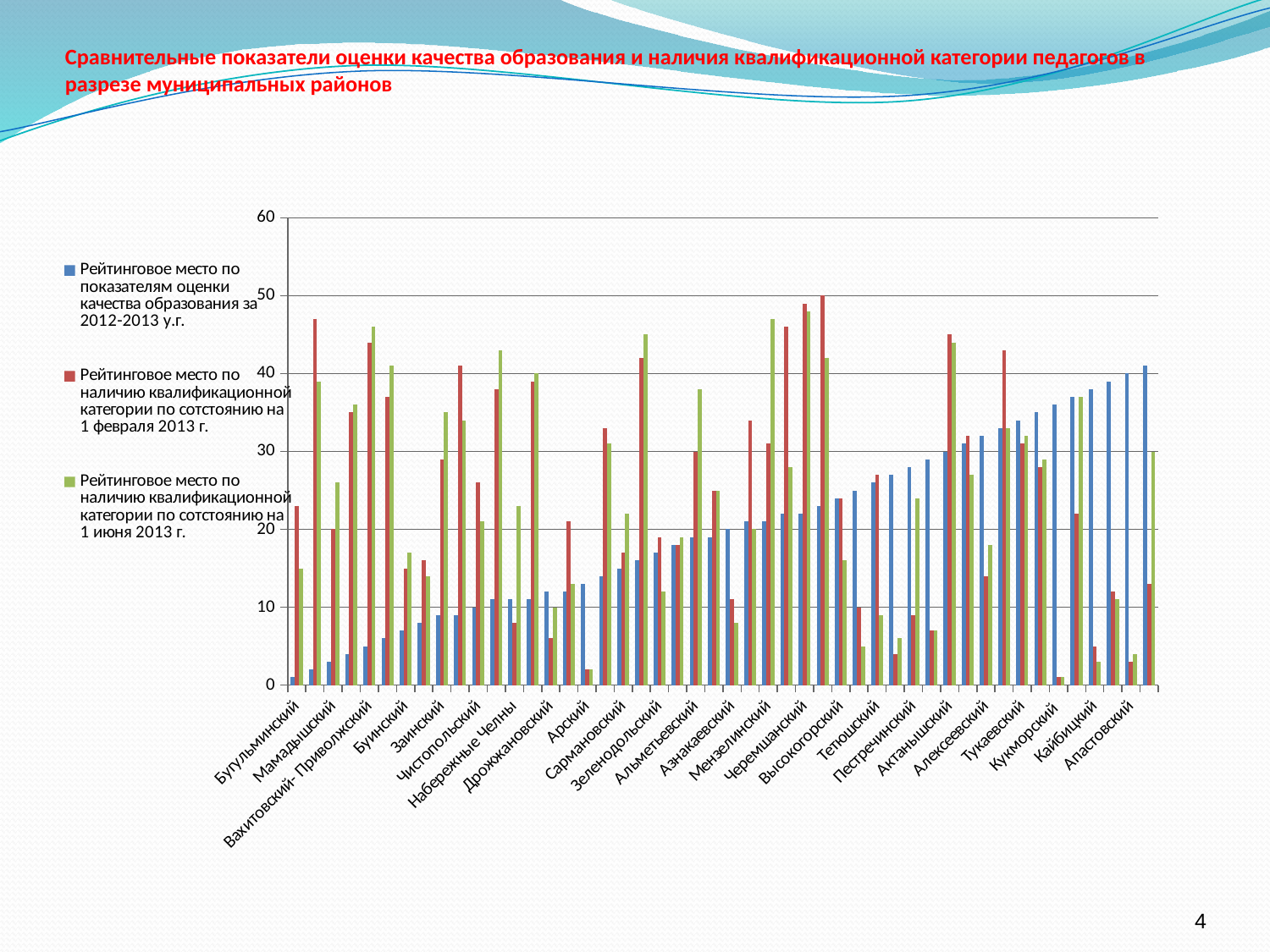
What is the legend entry for the blue series? Рейтинговое место по показателям оценки качества образования за 2012-2013 у.г. Is the value of the green series (квалификационная категория на 1 июня 2013 г.) for Бугульминский greater or less than 10? greater What kind of chart is shown on the slide? bar chart For Бугульминский, which series has the larger value: the blue series or the red series? the red series Is the value of the blue series (оценка качества образования) for Бугульминский greater or less than 10? less Is the value of the red series (квалификационная категория на 1 февраля 2013 г.) for Бугульминский greater or less than 20? greater For Бугульминский, which of the three series has the lowest value? the blue series (Рейтинговое место по показателям оценки качества образования за 2012-2013 у.г.) Do the values of the blue series (оценка качества образования) rise or fall from left to right along the x axis? rise What is the legend entry for the green series? Рейтинговое место по наличию квалификационной категории по сотстоянию на 1 июня 2013 г. How many series does the legend list? 3